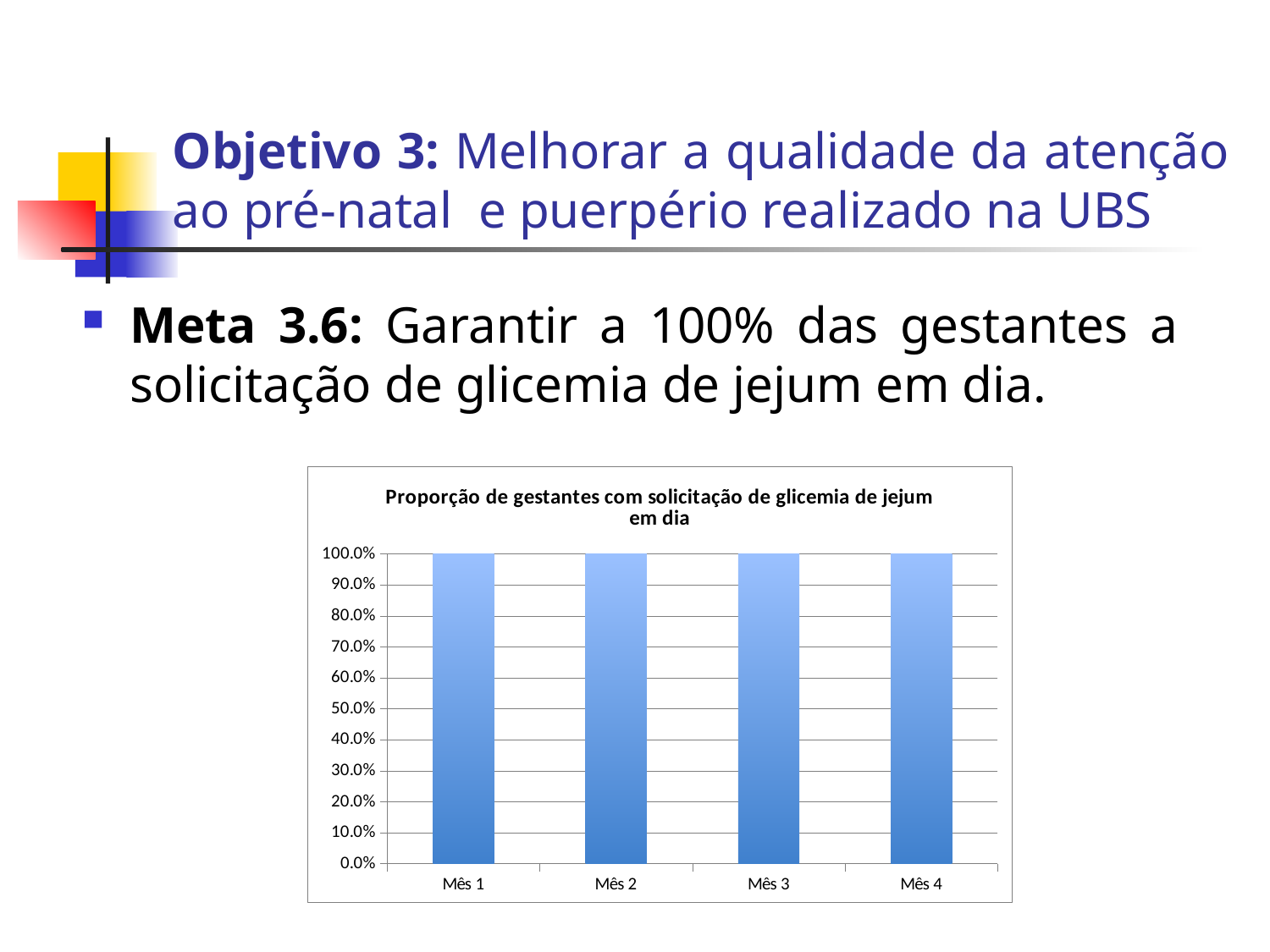
What is the difference between the values for Mês 1 and Mês 3? 0.0% How many categories (months) are plotted on the x axis of the chart? 4 What is the value for Mês 3 in the chart? 100.0% What is the value for Mês 2 in the chart? 100.0% Is the value for Mês 4 greater or less than 50.0%? greater What is the label of the first category on the x axis of the chart? Mês 1 Do the values rise, fall, or stay the same from Mês 1 to Mês 4? Stay the same Is the value for Mês 2 greater or less than 90.0%? greater What is the value for Mês 1 in the chart? 100.0% What is the value for Mês 4 in the chart? 100.0% What kind of chart is shown on the slide? Bar chart What is the title of the chart? Proporção de gestantes com solicitação de glicemia de jejum em dia